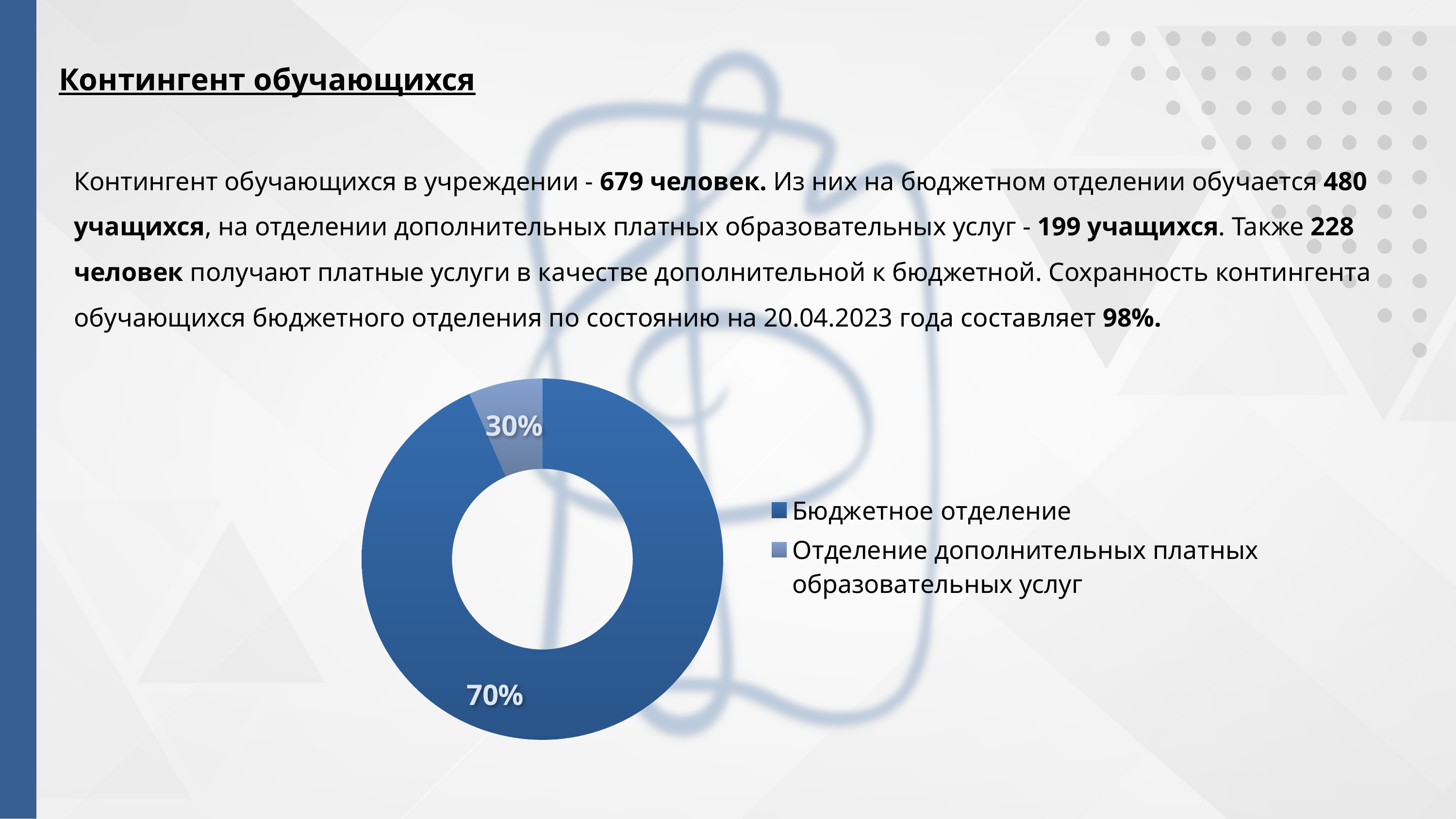
What share of the doughnut chart does "Бюджетное отделение" represent? 70% What is the title of the slide containing the chart? Контингент обучающихся Which category has the smallest share in the doughnut chart? Отделение дополнительных платных образовательных услуг What share of the doughnut chart does "Отделение дополнительных платных образовательных услуг" represent? 30% What kind of chart is shown on the slide? Doughnut chart Which category has the largest share in the doughnut chart? Бюджетное отделение Which is larger: the share of "Бюджетное отделение" or the share of "Отделение дополнительных платных образовательных услуг"? Бюджетное отделение Which legend entry is shown in the darker blue colour? Бюджетное отделение How many entries does the chart legend list? 2 How many categories are shown in the doughnut chart? 2 What is the total of the two shares shown in the doughnut chart? 100% What is the difference in percentage points between the shares of "Бюджетное отделение" and "Отделение дополнительных платных образовательных услуг"? 40%